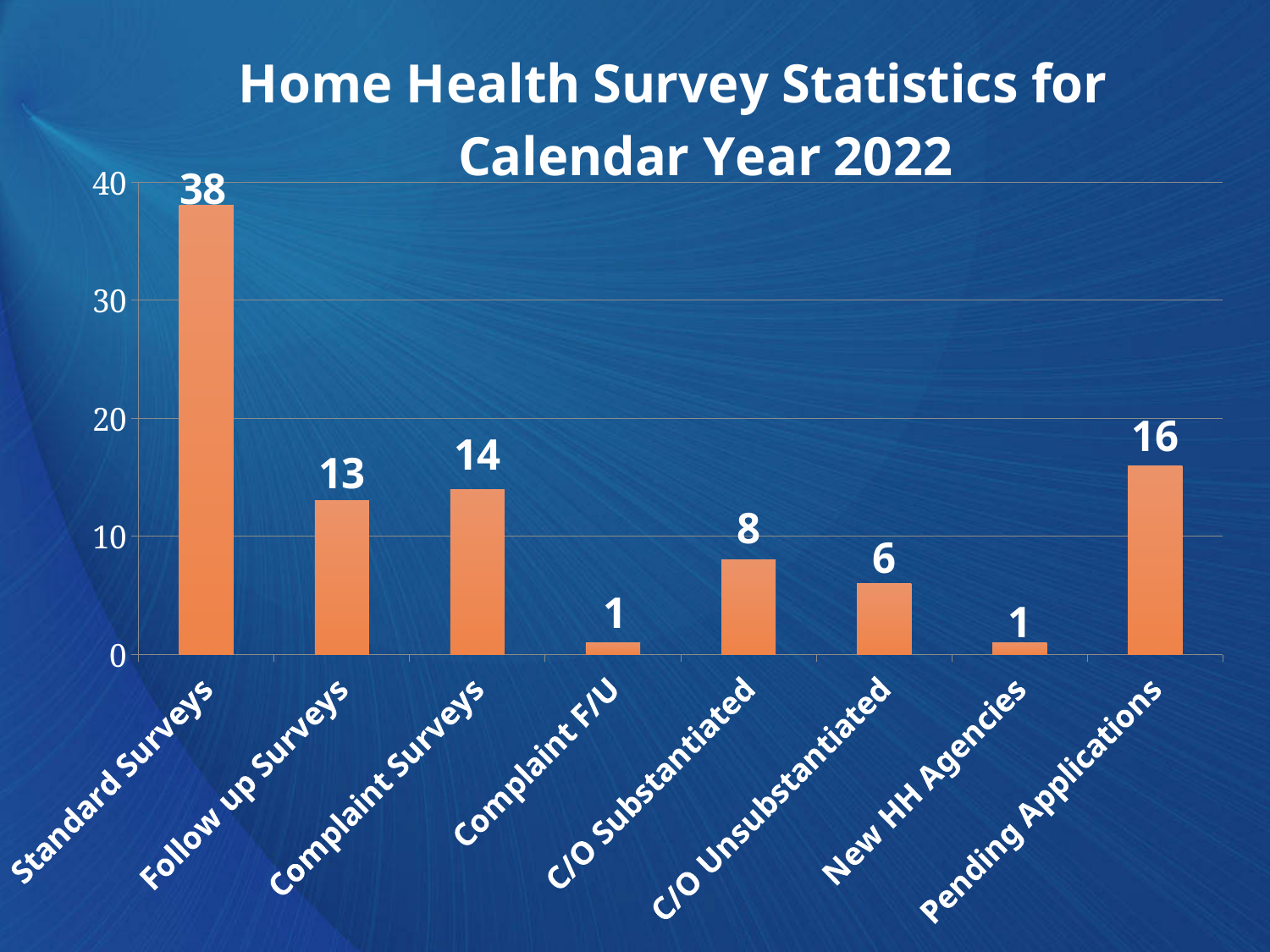
Is the value for Pending Applications greater or less than 20? less What is the value for Pending Applications? 16 What is the difference between Standard Surveys and Pending Applications? 22 How many categories are shown on the x axis? 8 What kind of chart is this? bar chart What is the value for C/O Unsubstantiated? 6 Which category has the highest value? Standard Surveys What is the value for Standard Surveys? 38 What is the title of the chart? Home Health Survey Statistics for Calendar Year 2022 What is the difference between Complaint Surveys and Follow up Surveys? 1 How many categories have a value of 1? 2 Which is larger, C/O Substantiated or C/O Unsubstantiated? C/O Substantiated